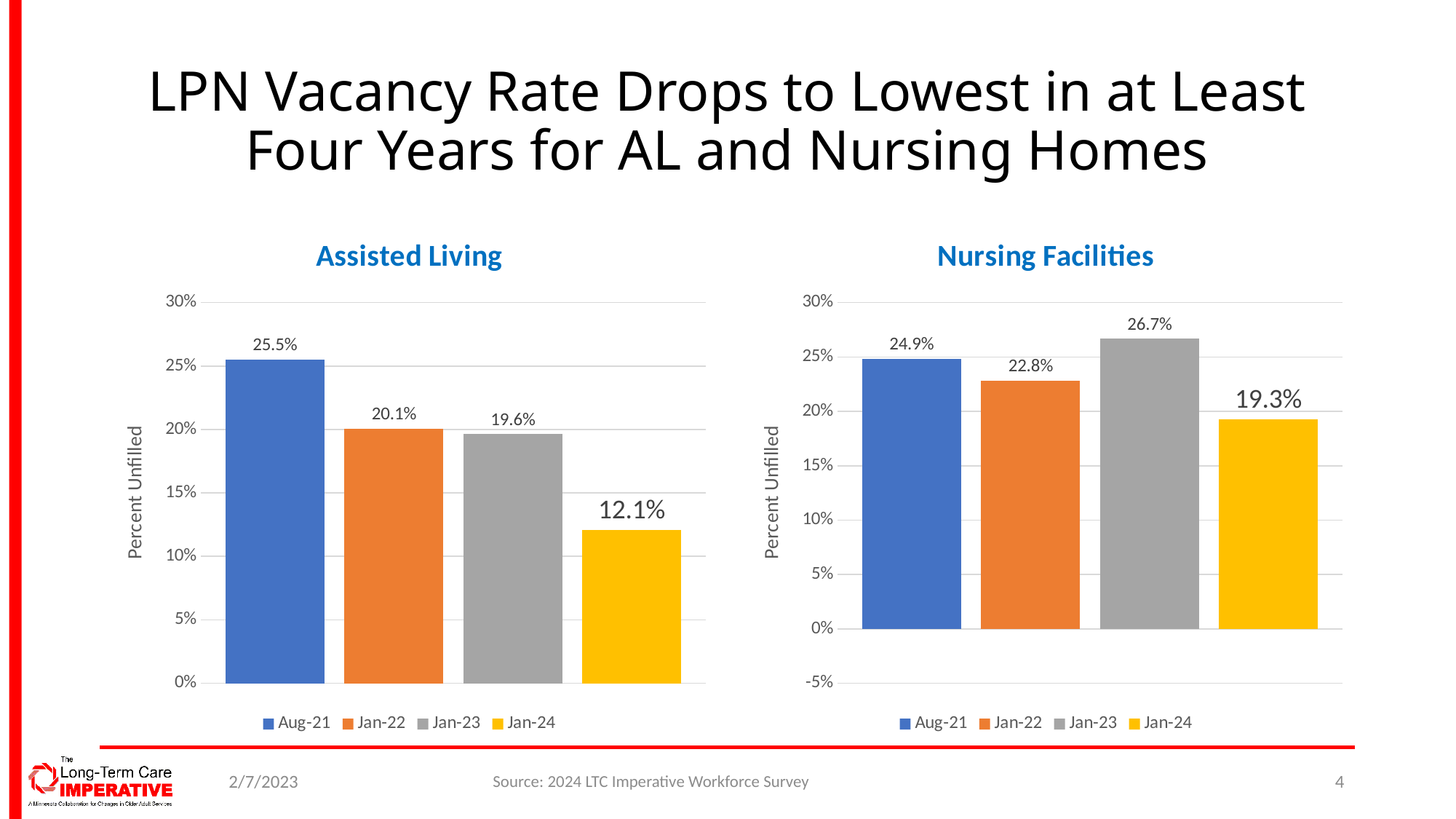
In the Assisted Living chart, what is the LPN vacancy rate for Jan-24? 12.1% In the Assisted Living chart, which period has the lowest vacancy rate? Jan-24 What kind of chart is the Nursing Facilities chart? Bar chart In the Assisted Living chart, what is the value for Aug-21? 25.5% How many series does the legend of the Assisted Living chart list? 4 In the Nursing Facilities chart, what is the value for Jan-22? 22.8% In the Nursing Facilities chart, what is the LPN vacancy rate for Jan-23? 26.7% What is the y-axis label on the Assisted Living chart? Percent Unfilled Which is larger: the Jan-24 value in the Assisted Living chart or the Jan-24 value in the Nursing Facilities chart? Nursing Facilities In the Assisted Living chart, what is the difference between the Aug-21 and Jan-24 values? 13.4% In the Nursing Facilities chart, which period has the highest vacancy rate? Jan-23 In the Nursing Facilities chart, what is the difference between the Jan-23 and Jan-24 values? 7.4%